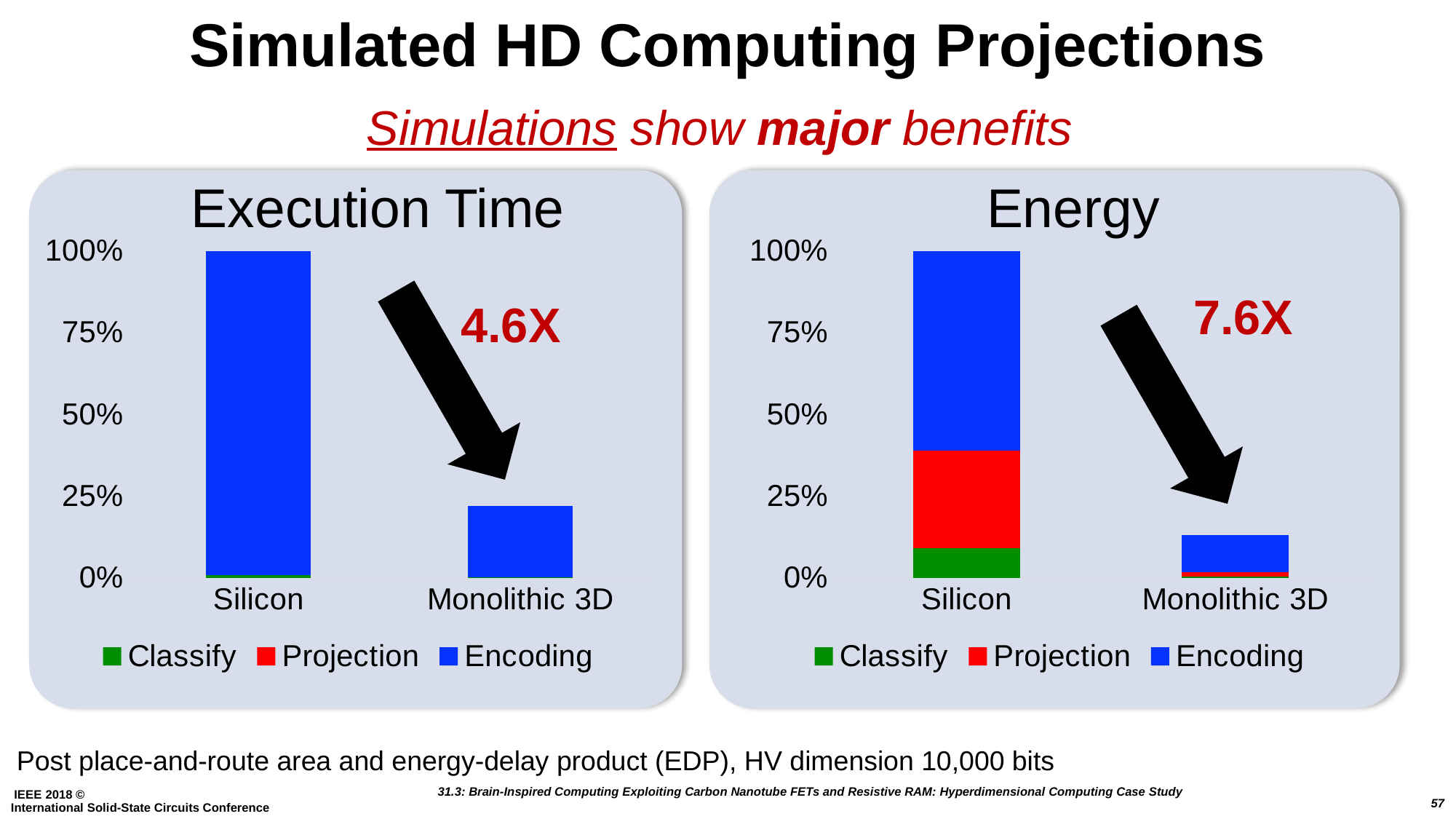
In the Energy chart, is the Encoding segment for Silicon larger or smaller than the Projection segment for Silicon? larger How many categories are shown on the x axis of the Energy chart? 2 Which colour represents the Encoding series in the legend of the Execution Time chart? blue In the Execution Time chart, what is the total height of the Silicon stacked bar? 100% What improvement factor is annotated on the Energy chart? 7.6X In the Execution Time chart, is the total for Monolithic 3D greater or less than 25%? less In the Energy chart, which category has the shorter bar? Monolithic 3D In the Energy chart, is the Projection segment for Silicon greater or less than 25% of the total? greater What kind of chart is the Execution Time chart? stacked bar chart How many series does the legend of the Execution Time chart list? 3 In the Execution Time chart, which category has the taller bar? Silicon In the Energy chart, is the total for Monolithic 3D greater or less than 25%? less